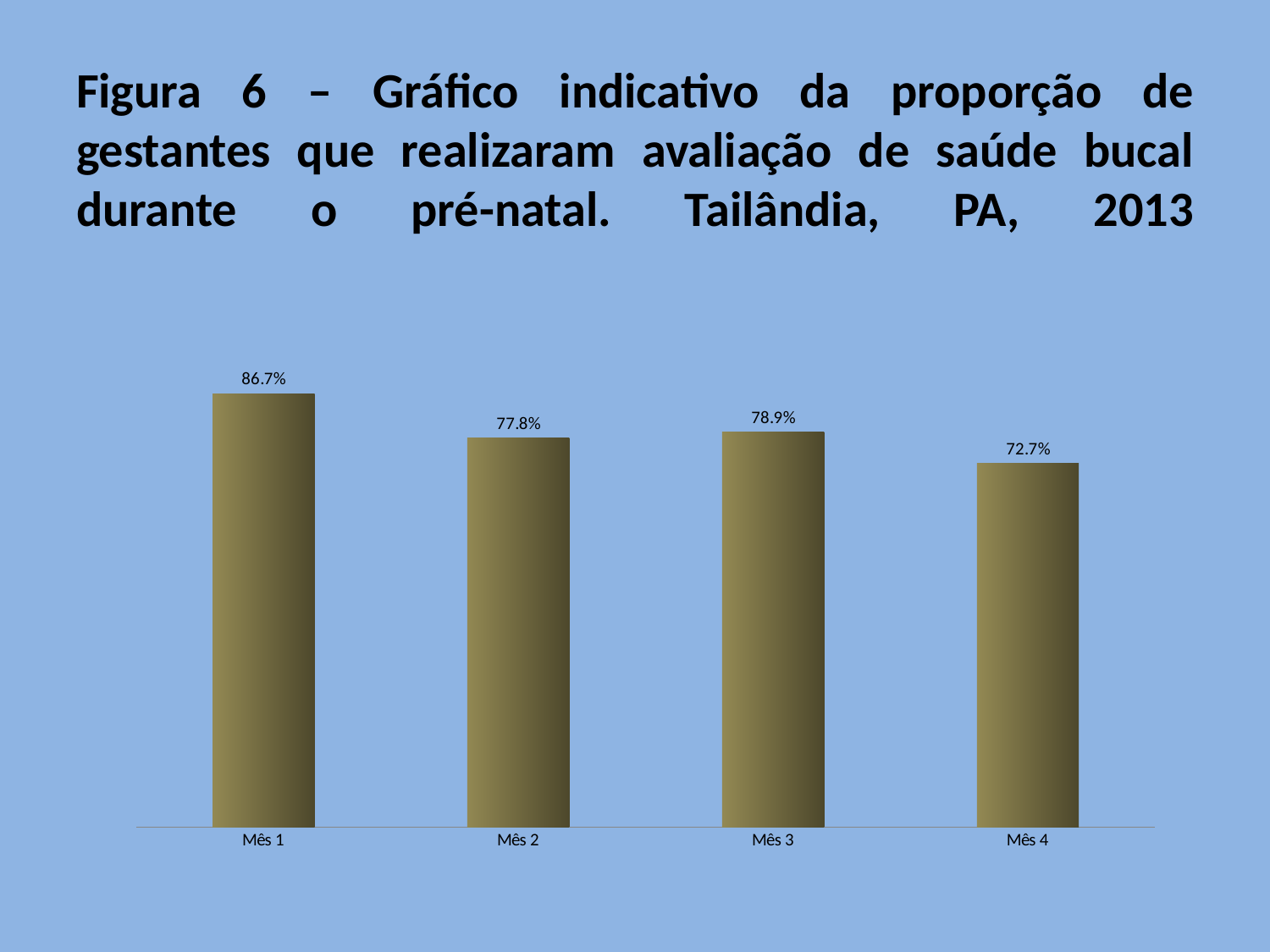
What is the value for Mês 1? 86.7% How many months are shown on the chart? 4 Which is larger, the value for Mês 1 or the value for Mês 3? Mês 1 Which month has the lowest value? Mês 4 What is the value for Mês 2? 77.8% Which month has the highest value? Mês 1 What is the value for Mês 4? 72.7% What is the difference between the values for Mês 3 and Mês 2? 1.1% What is the difference between the values for Mês 1 and Mês 4? 14.0% What kind of chart is shown on the slide? Bar chart Does the value rise or fall from Mês 3 to Mês 4? Fall What is the value for Mês 3? 78.9%